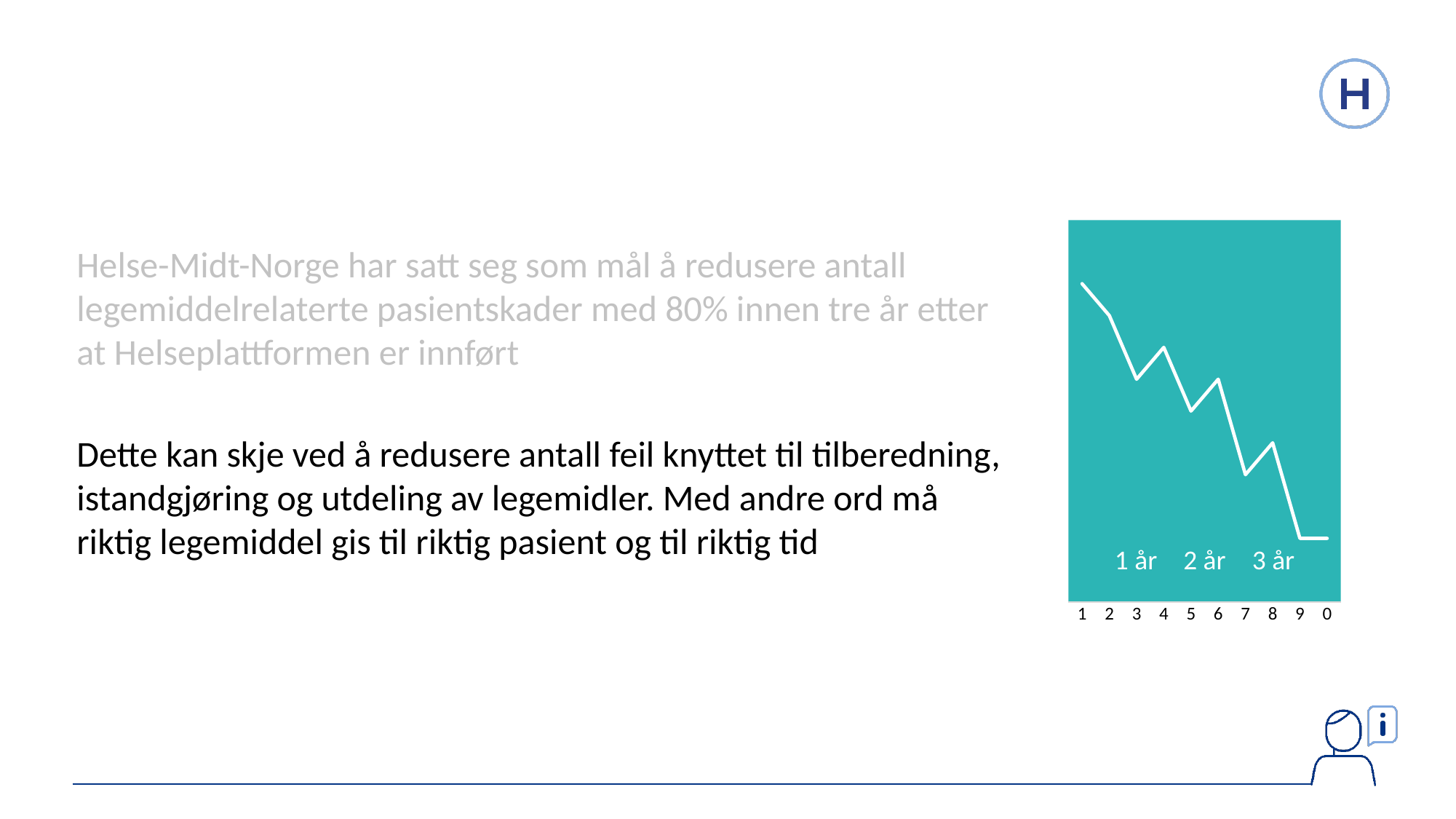
How many tick labels are shown along the x axis of the line chart? 10 Which x-axis point has the highest value in the line chart? 1 In the line chart, which is larger: the value at point 4 or the value at point 9? point 4 In the line chart, is the value at x-axis point 1 larger or smaller than the value at point 0? larger What are the three year labels printed inside the line chart area? 1 år, 2 år, 3 år What colour is the background of the line chart? teal What kind of chart is shown on the right side of the slide? line chart Do the values in the line chart rise or fall along the x axis overall? fall In the line chart, which is larger: the value at point 2 or the value at point 7? point 2